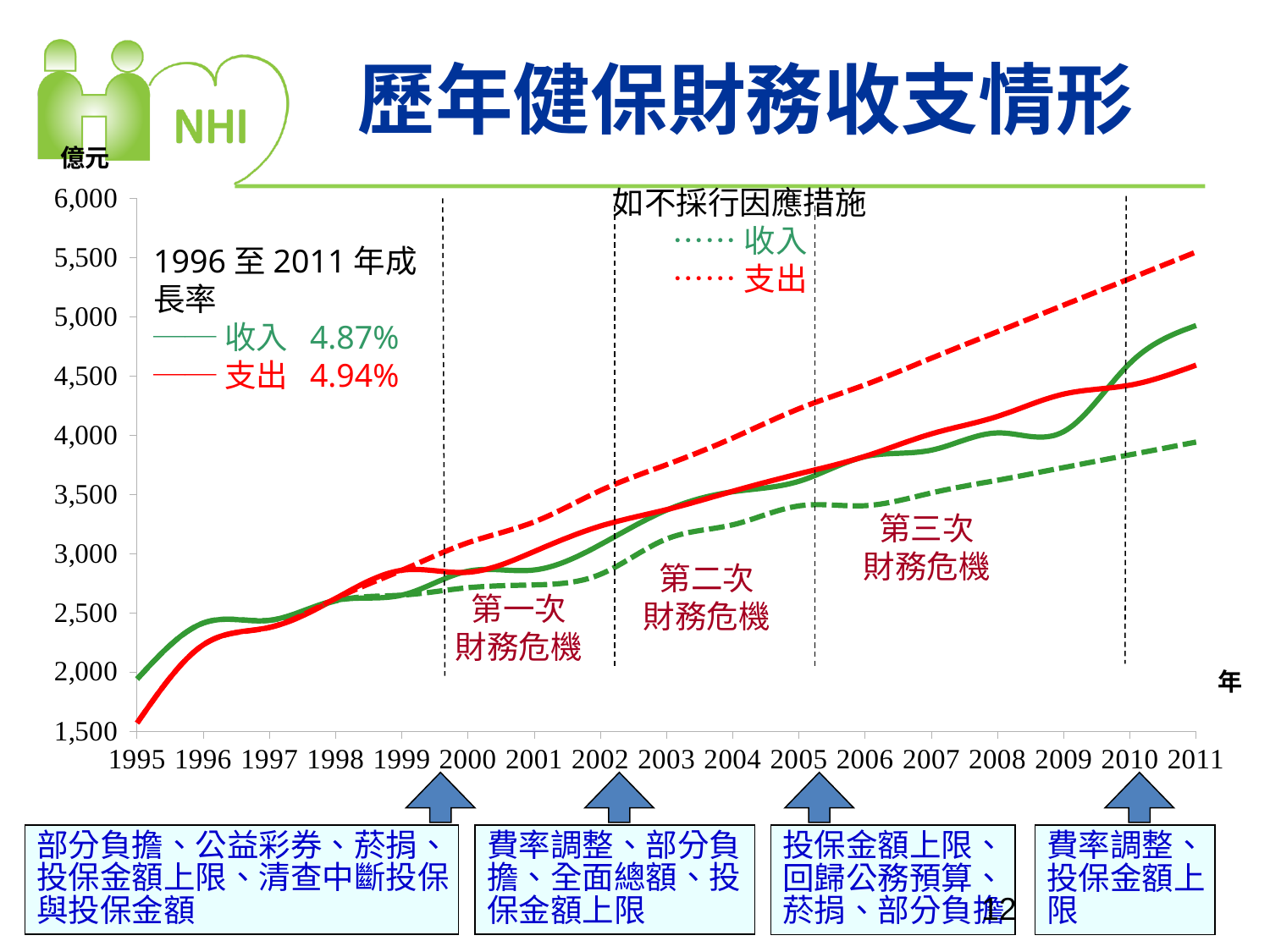
What unit is shown at the top of the y axis? 億元 Does the solid green 收入 line generally rise or fall from 1995 to 2011? rise How many years are labelled along the x axis of the chart? 17 What kind of chart is shown on the slide? line chart How many series does the chart's legend list in total (solid and dashed lines)? 4 What growth rate is printed for 支出 for 1996 至 2011? 4.94% In 2011, which is higher: the dashed red 支出 line or the solid green 收入 line? dashed red 支出 Is the value of the solid red 支出 line in 2011 greater or less than 4,000? greater Is the value of the solid red 支出 line in 1995 greater or less than 2,000? less Is the value of the dashed red 支出 (如不採行因應措施) line in 2011 greater or less than 5,000? greater What growth rate is printed for 收入 for 1996 至 2011? 4.87%